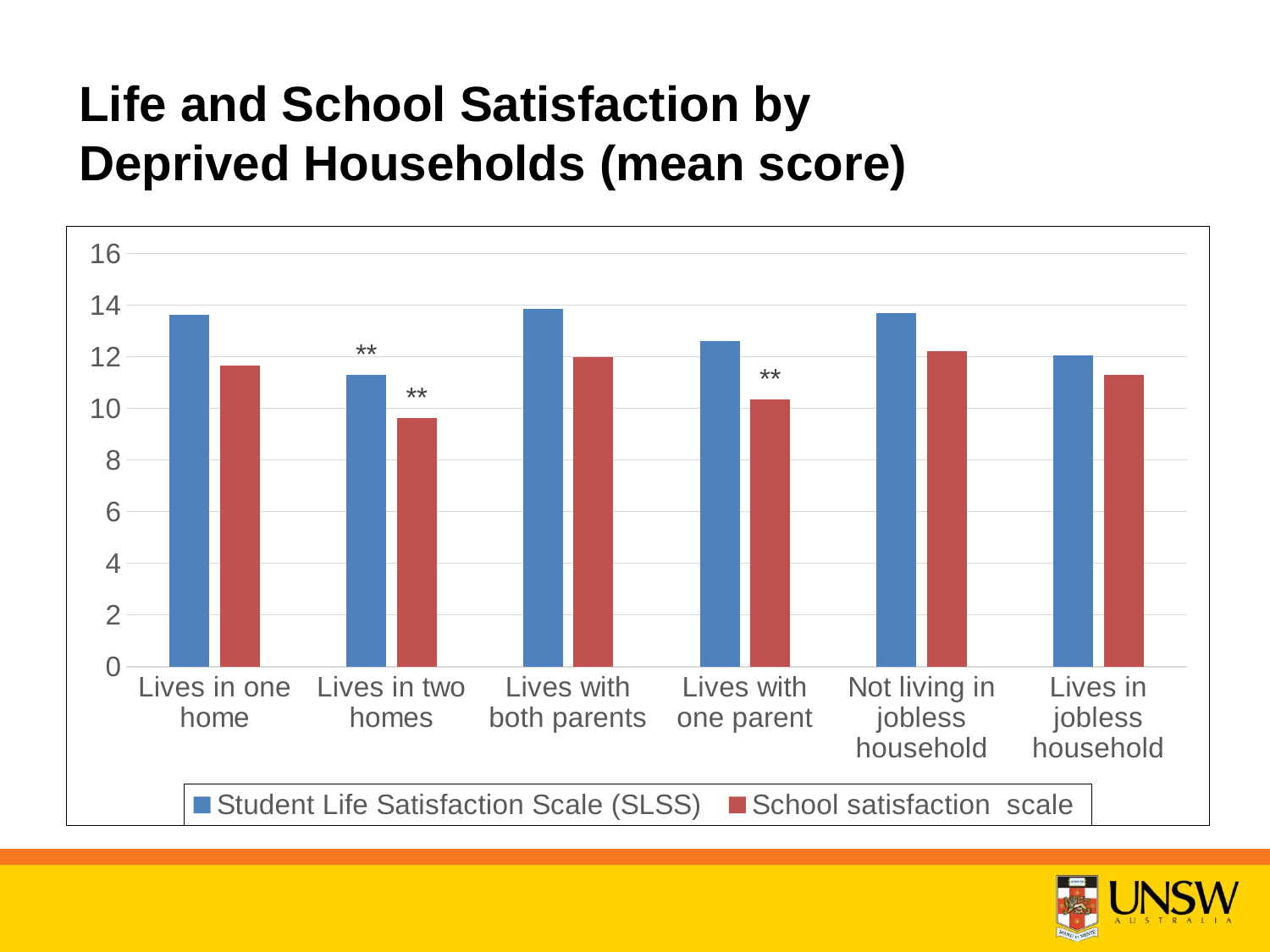
Which category has the lowest School satisfaction scale score? Lives in two homes Is the School satisfaction scale value for 'Lives in one home' greater or less than 12? less How many household categories are shown on the x axis? 6 Is the Student Life Satisfaction Scale (SLSS) value for 'Lives with both parents' greater or less than 12? greater Is the School satisfaction scale value for 'Lives in two homes' greater or less than 10? less What kind of chart is shown on the slide? bar chart Which is larger: the Student Life Satisfaction Scale (SLSS) score for 'Lives in one home' or for 'Lives in two homes'? Lives in one home Which category has the lowest Student Life Satisfaction Scale (SLSS) score? Lives in two homes What colour are the bars for the School satisfaction scale series? red How many series does the legend list? 2 For 'Lives with one parent', which is larger: the Student Life Satisfaction Scale (SLSS) score or the School satisfaction scale score? Student Life Satisfaction Scale (SLSS)